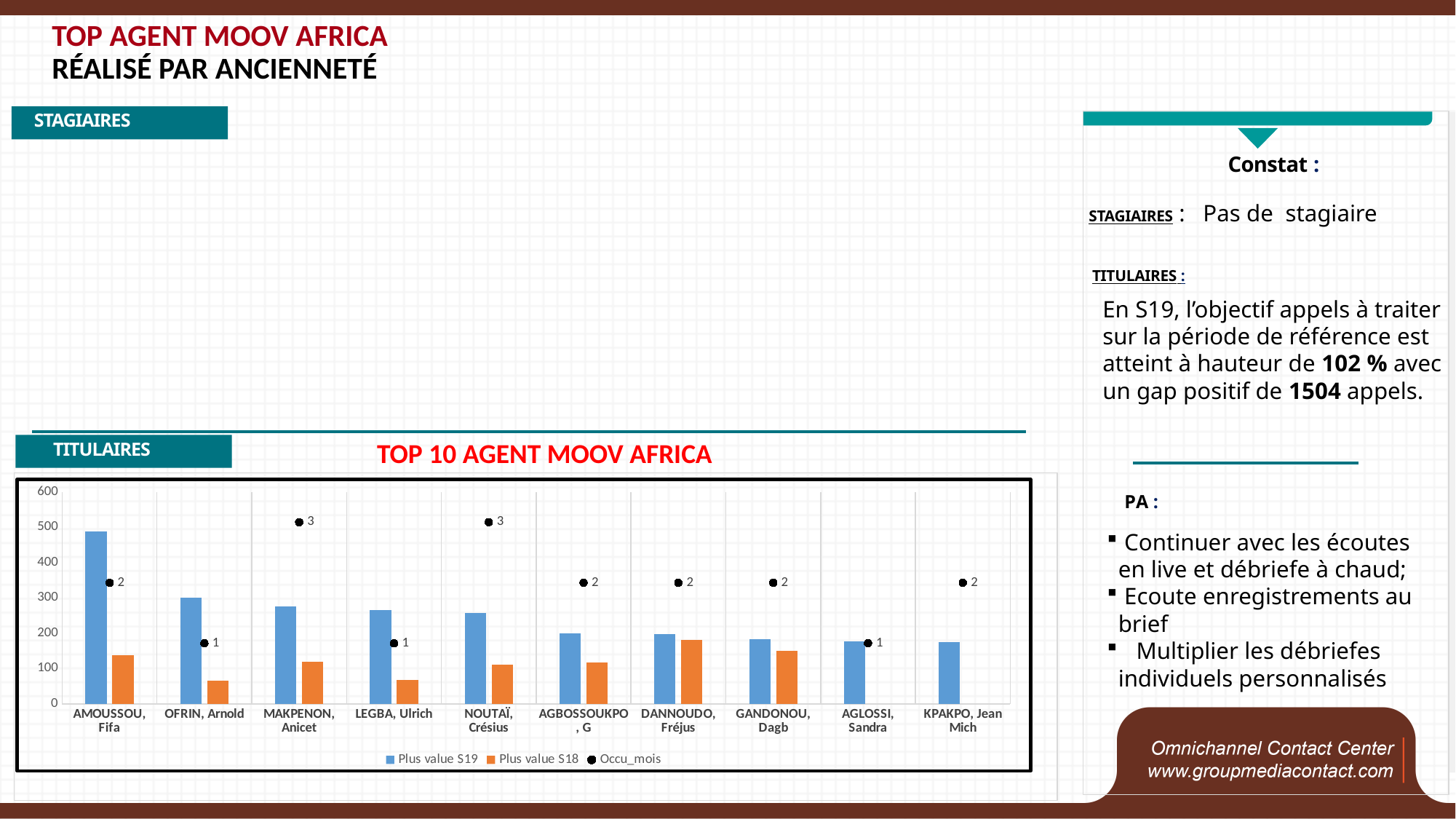
How many series does the chart legend list? 3 What is the title of the chart? TOP 10 AGENT MOOV AFRICA Which agent has the highest Plus value S18? DANNOUDO, Fréjus What is the Occu_mois value for AGLOSSI, Sandra? 1 How many agents are shown on the x axis of the chart? 10 What is the difference between the Occu_mois values of NOUTAÏ, Crésius and LEGBA, Ulrich? 2 What is the Occu_mois value for OFRIN, Arnold? 1 Is the Plus value S18 for OFRIN, Arnold greater or less than 100? less What is the Occu_mois value for AMOUSSOU, Fifa? 2 Which agent has the highest Plus value S19? AMOUSSOU, Fifa What is the Occu_mois value for MAKPENON, Anicet? 3 Is the Plus value S19 for AMOUSSOU, Fifa greater or less than 400? greater